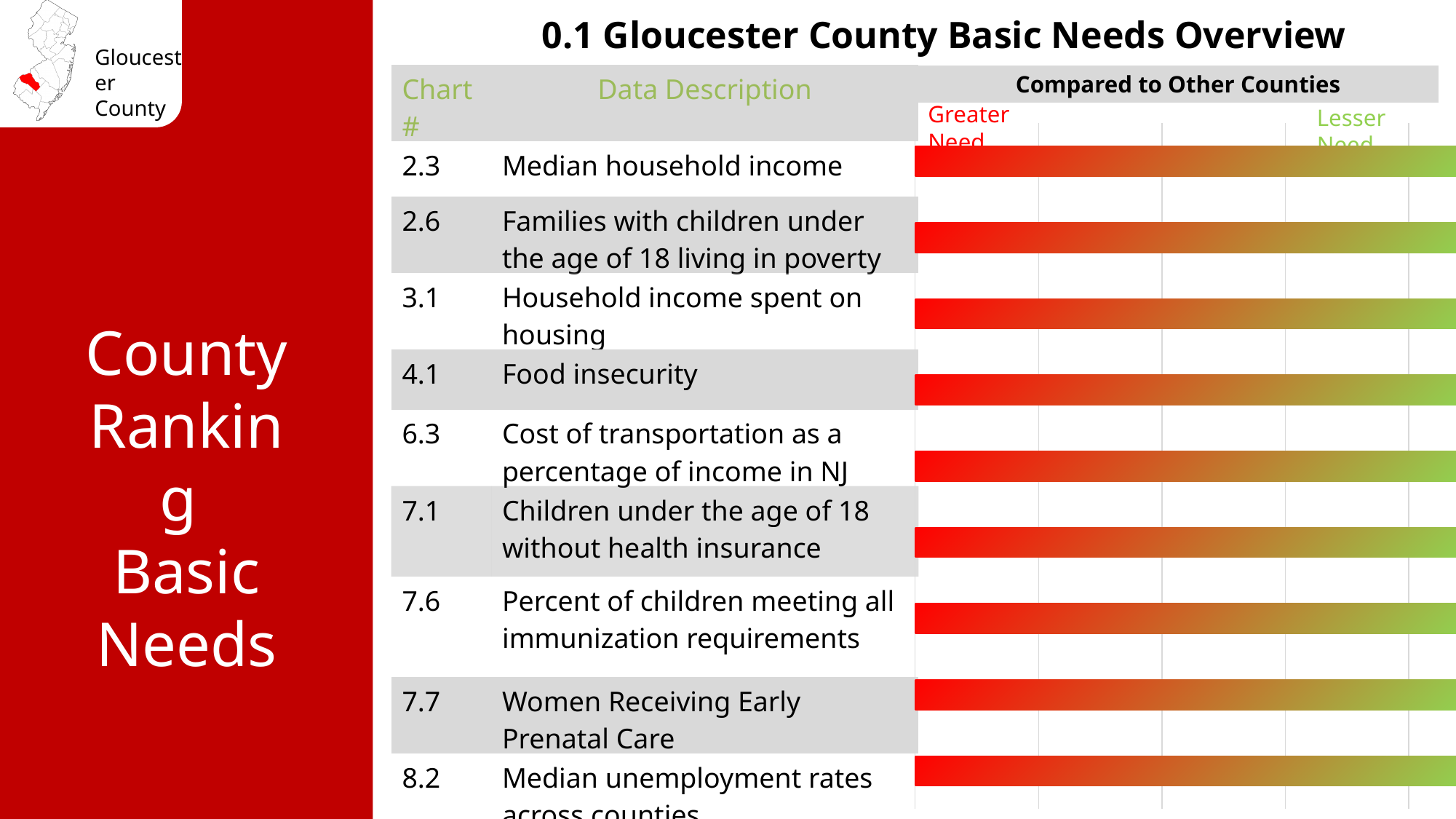
Which chart number is listed for Household income spent on housing? 3.1 What is the title of the chart? 0.1 Gloucester County Basic Needs Overview Which chart number is listed for Median household income? 2.3 Which data description is listed for chart number 7.7? Women Receiving Early Prenatal Care What kind of chart is shown on the slide? bar chart What label appears at the left end of the bar scale, and what label appears at the right end? Greater Need; Lesser Need Which chart number is listed for Food insecurity? 4.1 Which data description is listed for chart number 8.2? Median unemployment rates across counties How many data descriptions (rows) are listed in the chart? 9